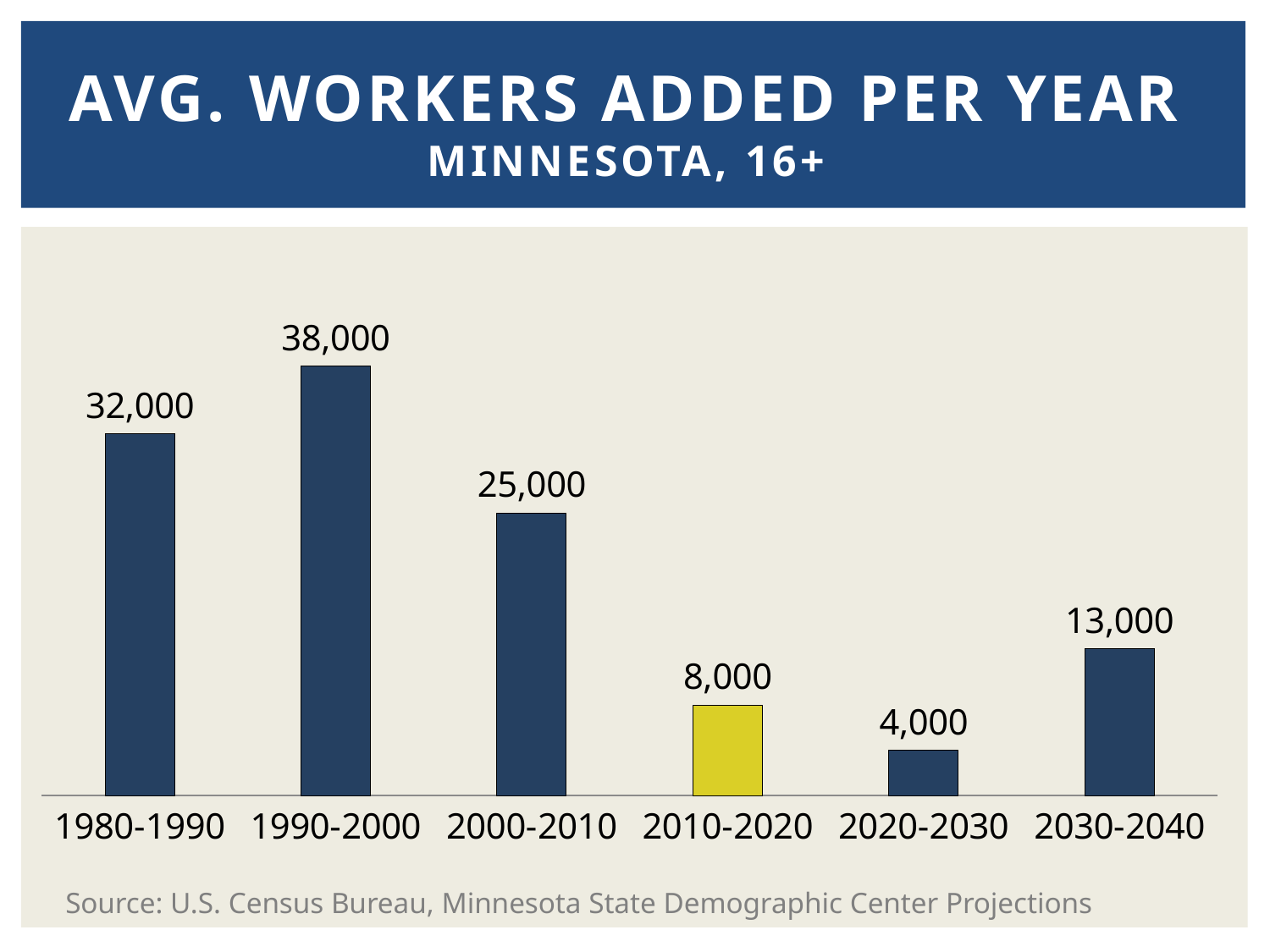
Which bar is highlighted in yellow? 2010-2020 What is the average number of workers added per year for 2020-2030? 4,000 What kind of chart is shown on the slide? Bar chart What is the difference between the values for 1990-2000 and 2000-2010? 13,000 Which decade has the lowest average workers added per year? 2020-2030 Do the values rise or fall from 1990-2000 to 2020-2030? Fall How many decades are shown on the chart? 6 Which decade has the highest average workers added per year? 1990-2000 What is the average number of workers added per year for 1990-2000? 38,000 Which is larger, the value for 2010-2020 or the value for 2030-2040? 2030-2040 What is the difference between the values for 1980-1990 and 2030-2040? 19,000 What is the value shown for 2010-2020? 8,000